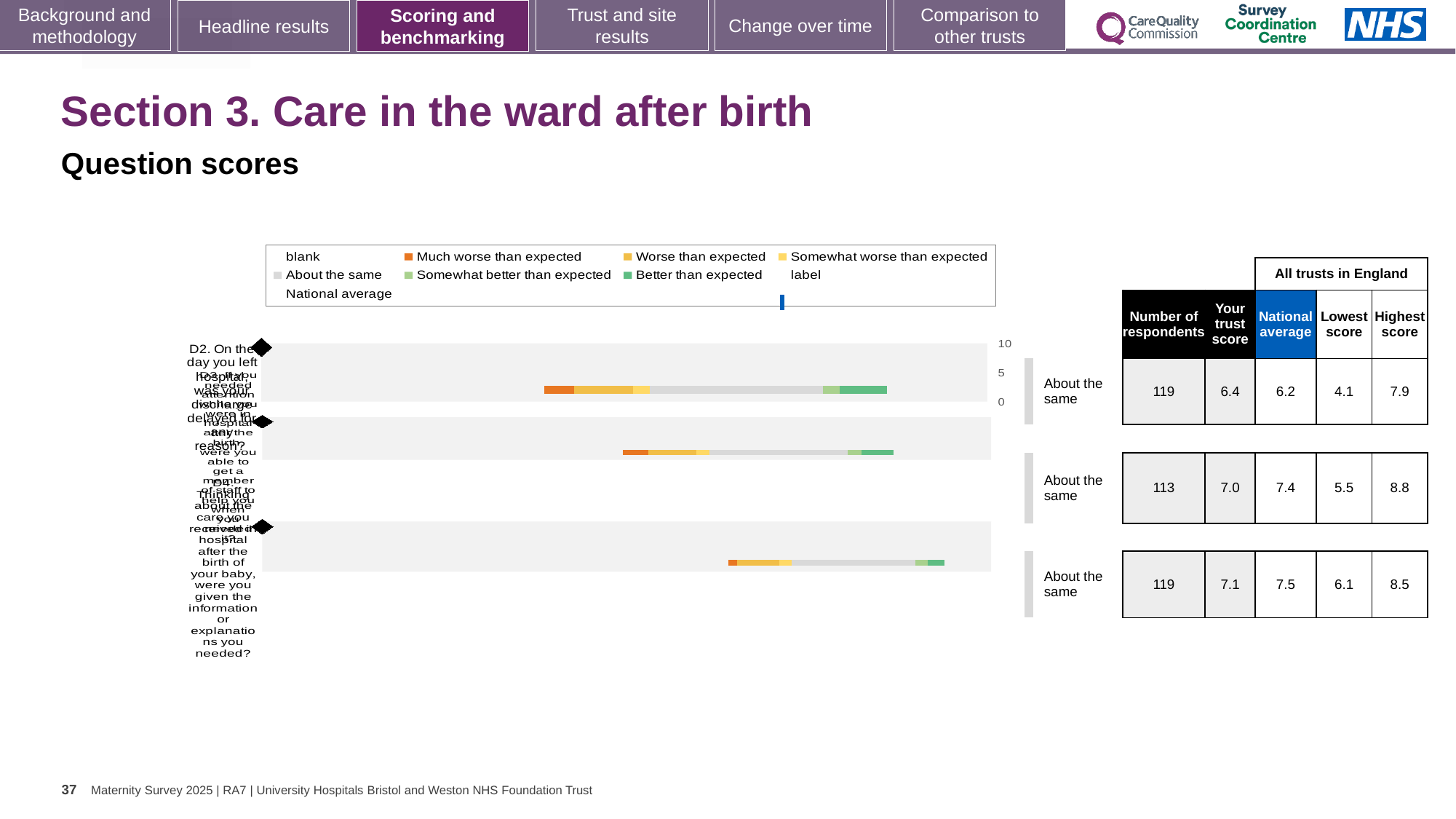
How many horizontal bars are plotted in the chart? 3 What kind of chart is shown on the slide? bar chart In the chart legend, what colour represents 'Better than expected'? green What rating label is shown beside the bottom bar of the chart? About the same What rating label is shown beside the top bar of the chart? About the same In the chart legend, what colour represents 'Much worse than expected'? orange